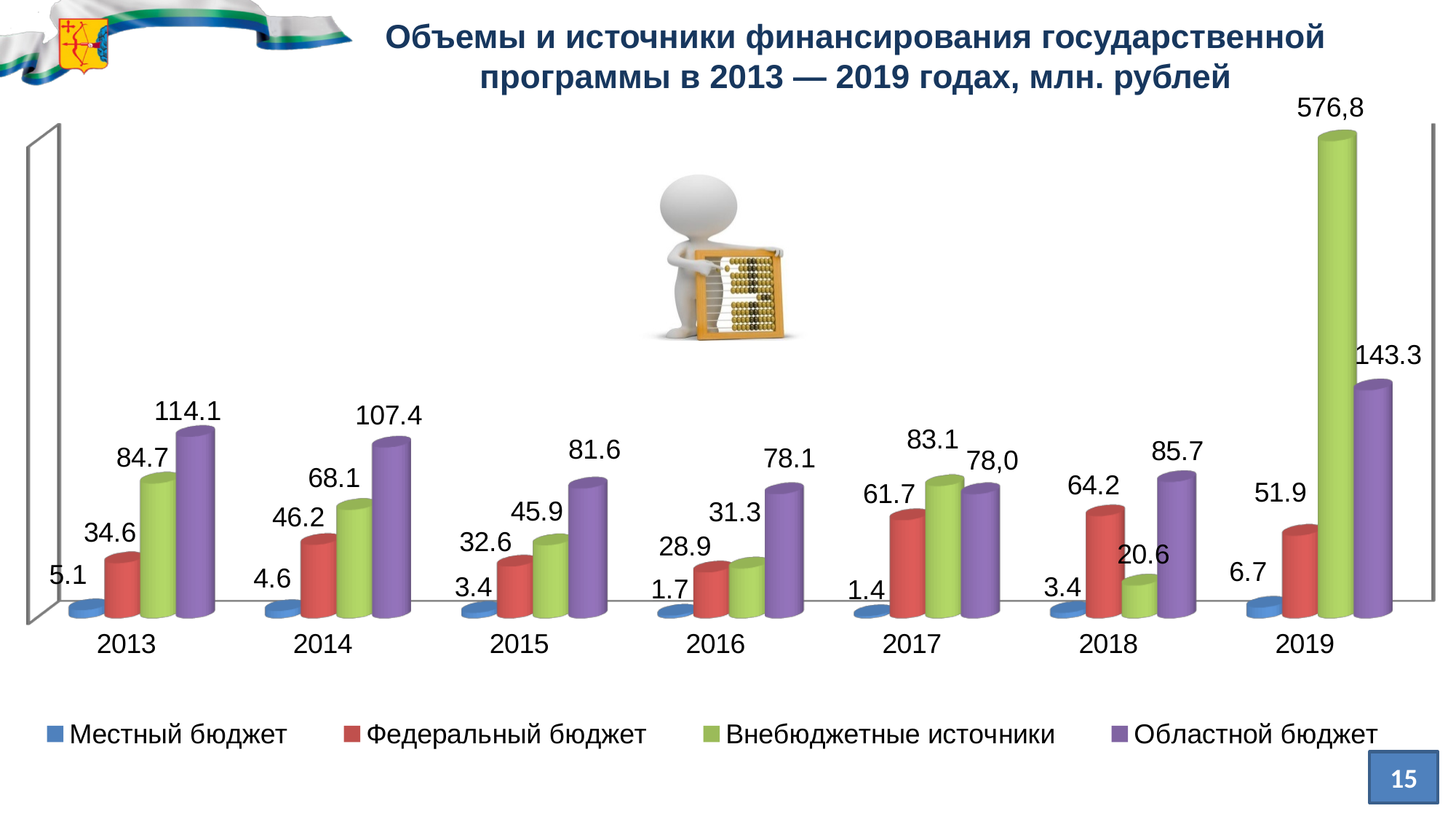
In which year is the Областной бюджет value highest? 2019 What is the value for Внебюджетные источники in 2019? 576,8 What is the value for Федеральный бюджет in 2017? 61.7 What is the value for Областной бюджет in 2013? 114.1 Does the Местный бюджет value rise or fall from 2013 to 2016? fall Which is larger in 2018: Федеральный бюджет or Внебюджетные источники? Федеральный бюджет How many series does the legend list? 4 What kind of chart is shown on the slide? bar chart What is the difference between Областной бюджет and Внебюджетные источники in 2014? 39.3 In which year is the Местный бюджет value lowest? 2017 How many years are shown on the x axis? 7 What is the value for Местный бюджет in 2016? 1.7